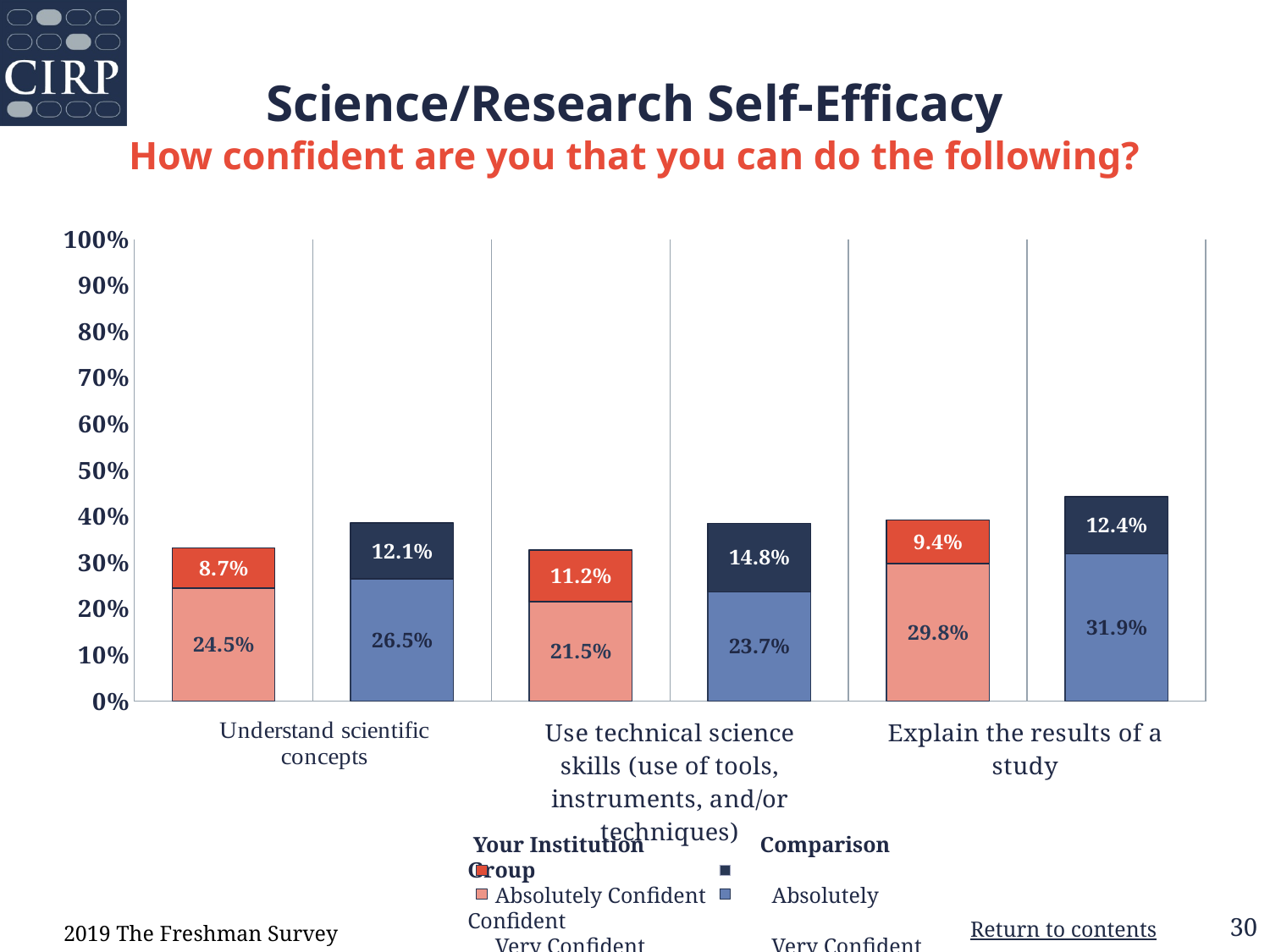
What percentage of Your Institution students are Absolutely Confident they can explain the results of a study? 9.4% What percentage of the Comparison Group is Absolutely Confident they can use technical science skills? 14.8% Which is larger: the Absolutely Confident value for Your Institution or for the Comparison Group on 'Understand scientific concepts'? Comparison Group Is the total height of the Comparison Group bar for 'Explain the results of a study' greater or less than 40%? greater What is the difference between the Comparison Group and Your Institution Very Confident values for 'Use technical science skills'? 2.2% What percentage of Your Institution students are Very Confident they can understand scientific concepts? 24.5% Among the Your Institution Very Confident values, which item has the lowest percentage? Use technical science skills (use of tools, instruments, and/or techniques) Among the Your Institution Very Confident values, which item has the highest percentage? Explain the results of a study What is the total percentage (Very Confident plus Absolutely Confident) for the Your Institution bar for 'Understand scientific concepts'? 33.2% How many survey items (categories) are shown on the x axis? 3 What is the total percentage (Very Confident plus Absolutely Confident) for the Comparison Group bar for 'Explain the results of a study'? 44.3% What type of chart is shown on the slide? Stacked bar chart